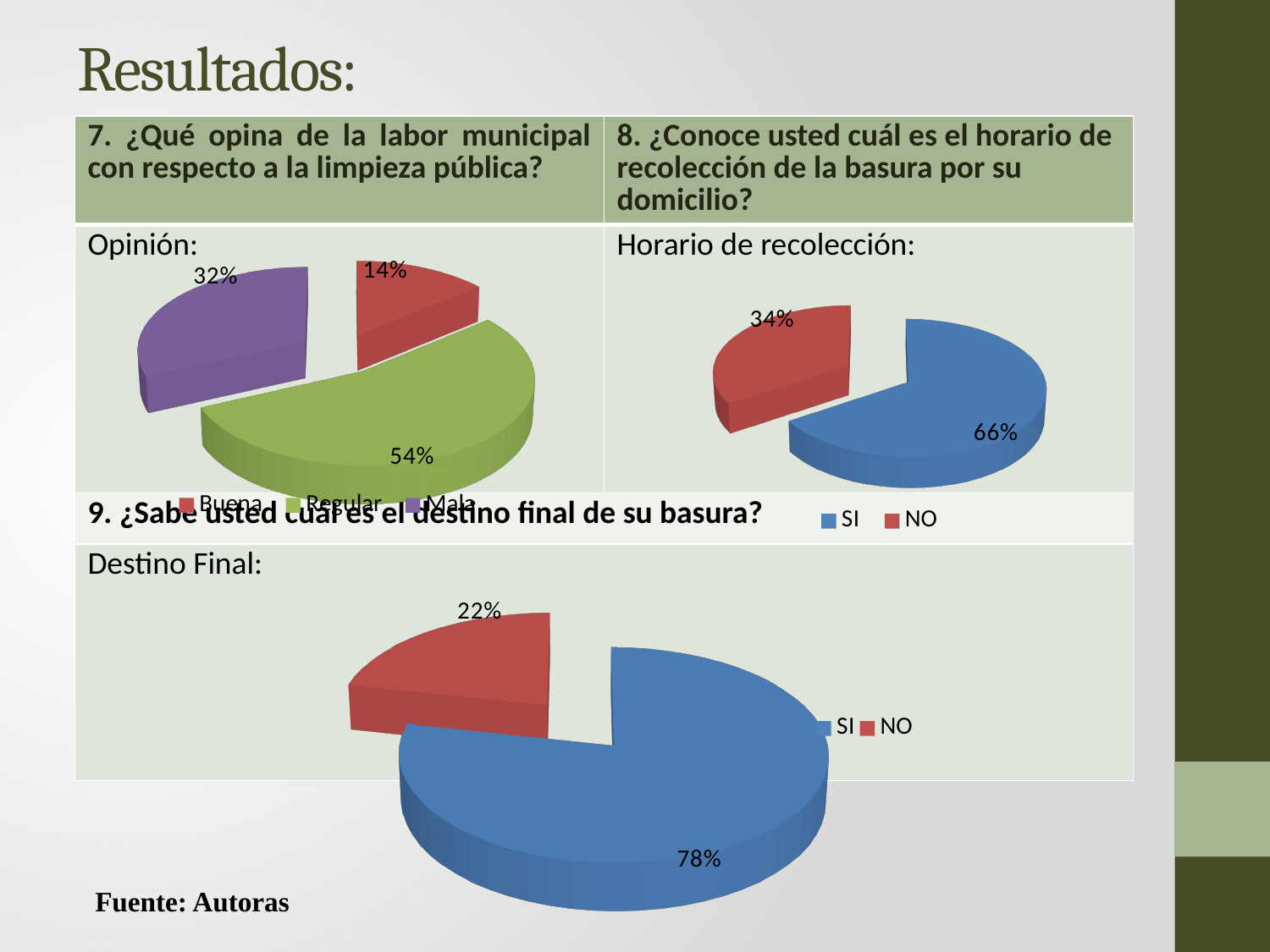
In the 'Opinión' chart, which category has the largest share? Regular In the 'Destino Final' chart, what percentage answered NO? 22% In the 'Destino Final' chart, which is larger, SI or NO? SI In the 'Opinión' chart, how many slices does the pie have? 3 In the 'Horario de recolección' chart, what colour is the SI slice? Blue In the 'Opinión' chart, what percentage is shown for the Mala slice? 32% In the 'Horario de recolección' chart, what percentage answered SI? 66% In the 'Opinión' chart, what percentage is shown for the Regular slice? 54% In the 'Opinión' chart, which category has the smallest share? Buena In the 'Destino Final' chart, what is the difference between the SI and NO shares? 56% What type of chart is used for 'Destino Final'? Pie chart In the 'Horario de recolección' chart, what is the difference between the SI and NO shares? 32%